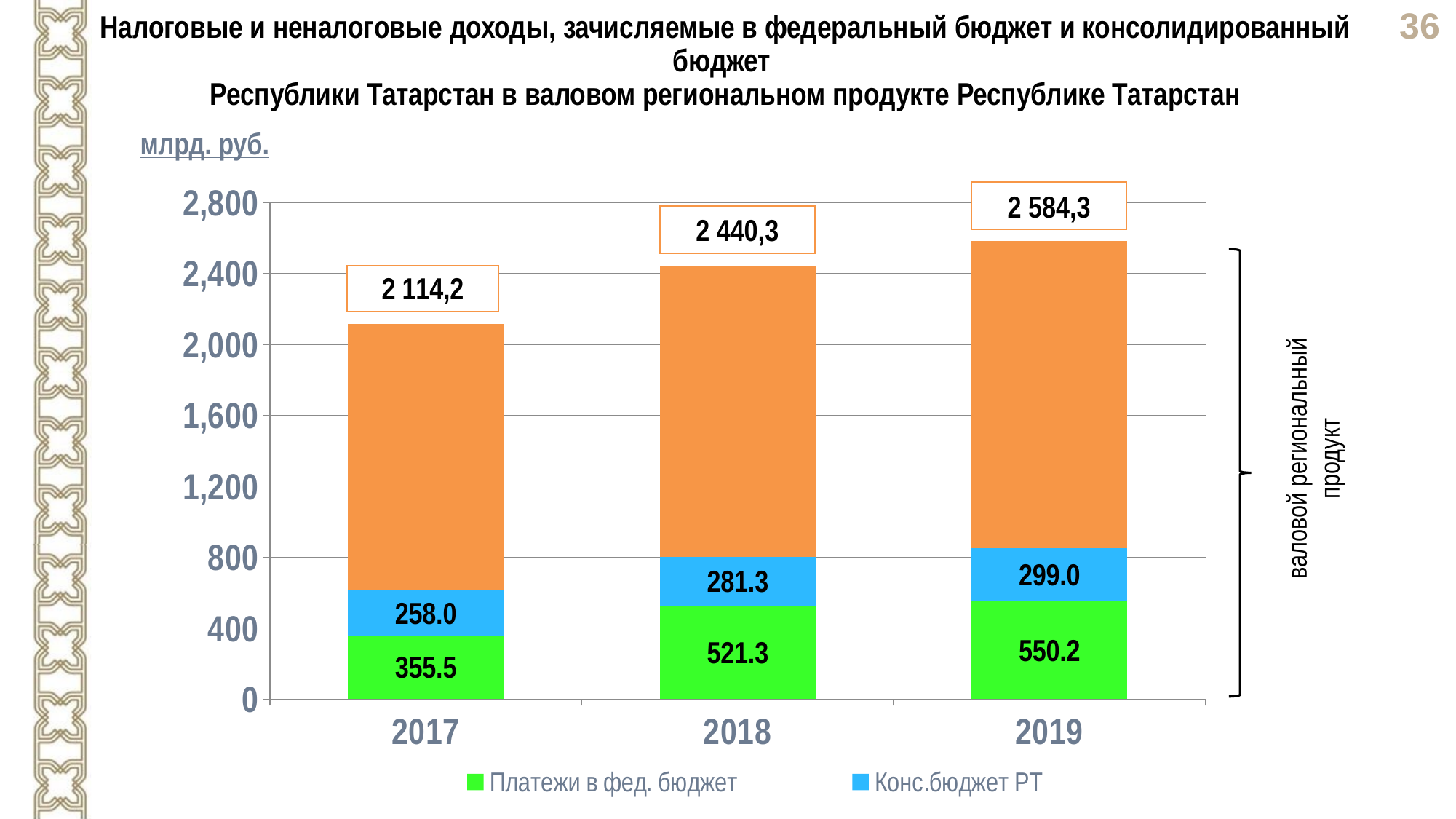
What total is labelled above the bar for 2018? 2 440,3 What is the value of Платежи в фед. бюджет for 2017? 355.5 In which year is Платежи в фед. бюджет the highest? 2019 How many series does the legend list? 2 In which year is Конс.бюджет РТ the lowest? 2017 Which is larger: Конс.бюджет РТ in 2018 or Платежи в фед. бюджет in 2017? Платежи в фед. бюджет in 2017 What is the difference between Платежи в фед. бюджет in 2018 and in 2017? 165.8 Do the total bar values rise or fall from 2017 to 2019? Rise What is the value of Конс.бюджет РТ for 2019? 299.0 How many years are shown on the x axis? 3 What kind of chart is shown on the slide? Stacked bar chart What is the value of Платежи в фед. бюджет for 2018? 521.3